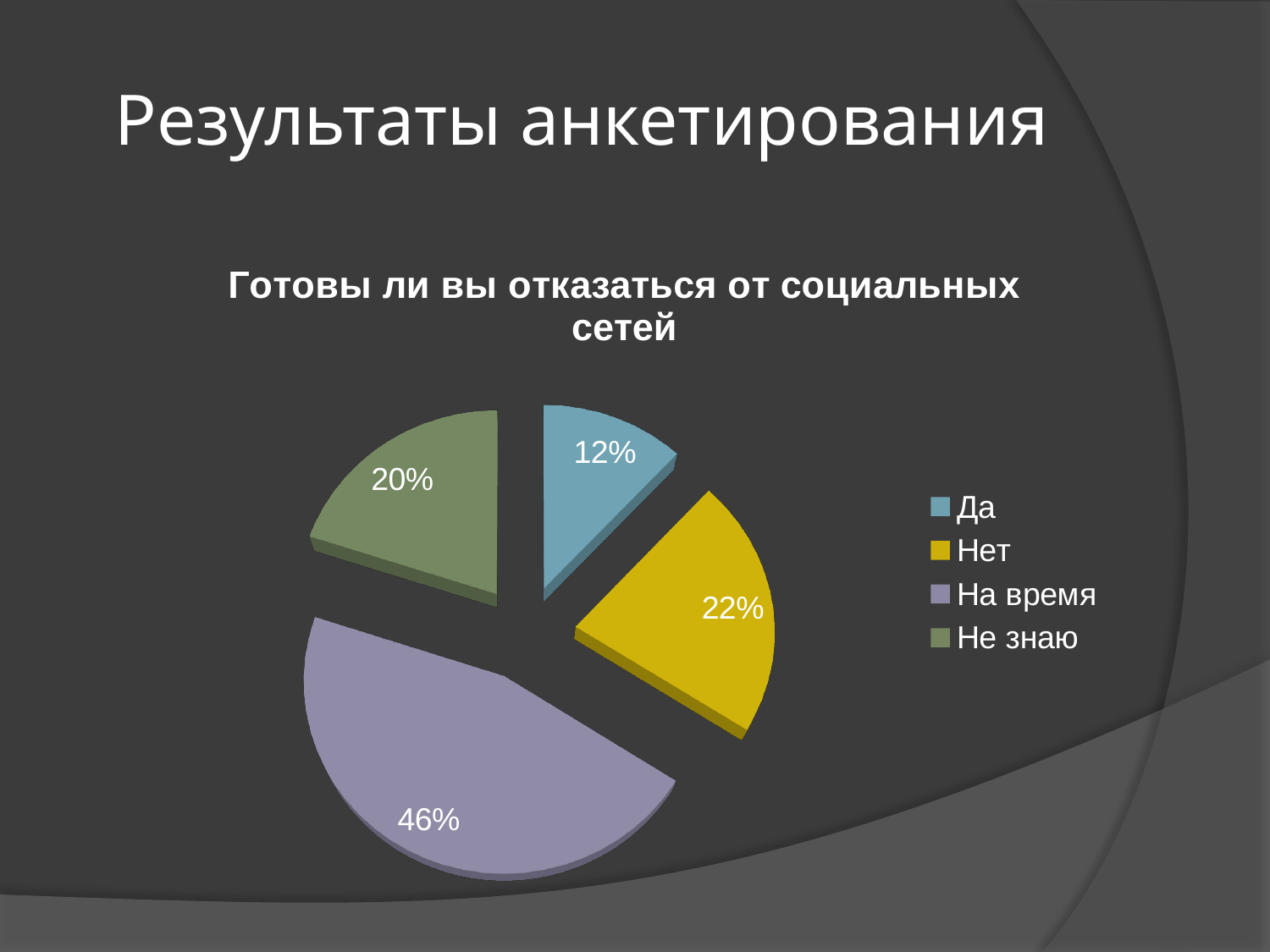
What share of respondents answered "Нет"? 22% What is the title of the chart? Готовы ли вы отказаться от социальных сетей What type of chart is shown on the slide? Pie chart How many slices does the pie chart have? 4 How many entries does the legend list? 4 What share of respondents answered "Не знаю"? 20% Which is larger, the share for "Нет" or the share for "Не знаю"? Нет Which answer has the largest share of the pie? На время What share of respondents answered "На время"? 46% What is the difference in percentage points between "На время" and "Нет"? 24 Which answer has the smallest share of the pie? Да What share of respondents answered "Да"? 12%